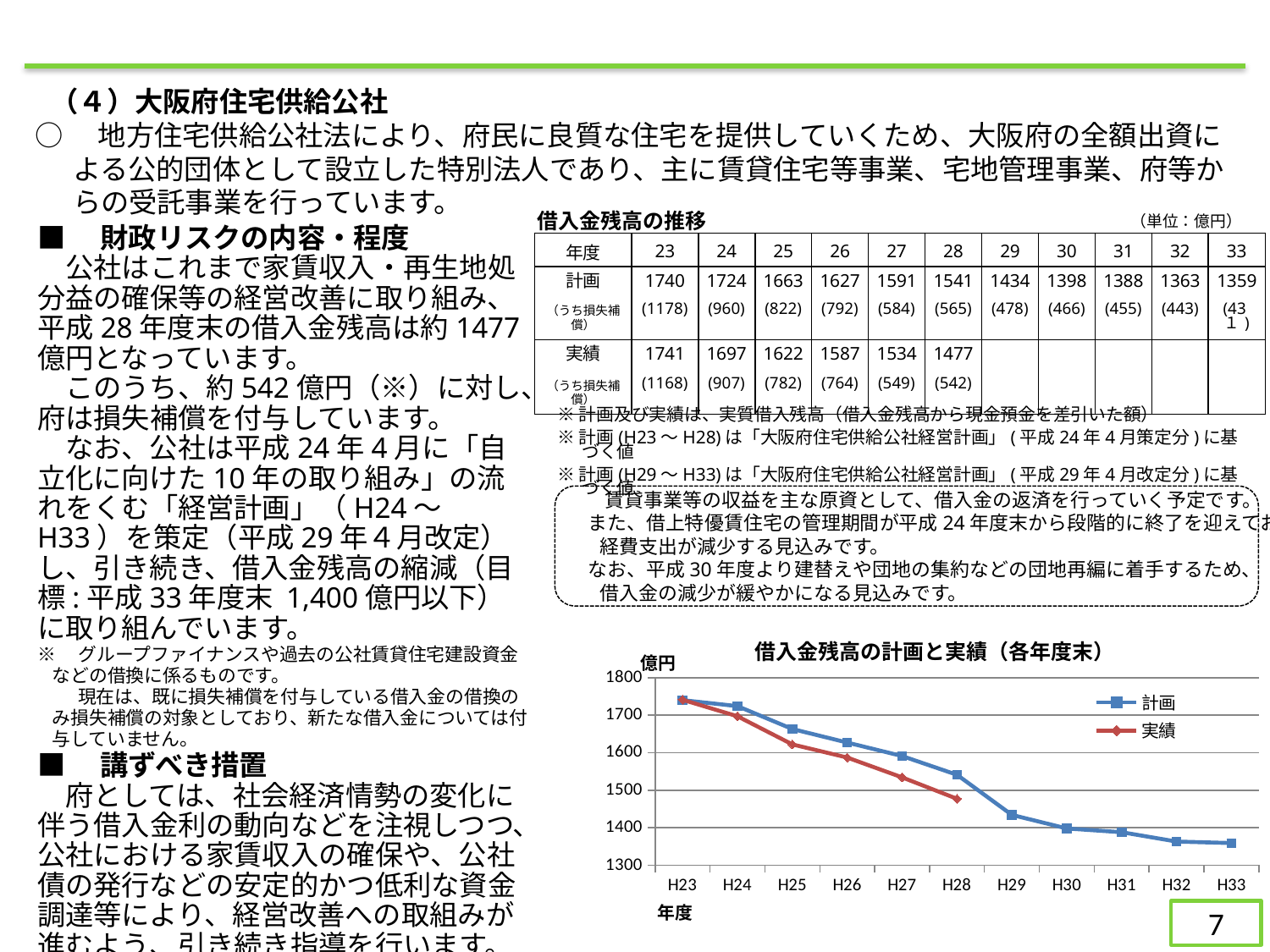
What are the two legend entries in the chart 「借入金残高の計画と実績（各年度末）」? 計画 and 実績 How many series does the legend of the chart 「借入金残高の計画と実績（各年度末）」 list? 2 In the chart 「借入金残高の計画と実績（各年度末）」, at which year is the 実績 series lowest? H28 In the chart 「借入金残高の計画と実績（各年度末）」, how many points are plotted for the 計画 series? 11 According to the table 「借入金残高の推移」, what is the 実績 value for year 28? 1477 In the chart 「借入金残高の計画と実績（各年度末）」, is the 実績 value for H27 greater or less than 1500? greater In the chart 「借入金残高の計画と実績（各年度末）」, how many points are plotted for the 実績 series? 6 In the chart 「借入金残高の計画と実績（各年度末）」, at H28 which series has the higher value, 計画 or 実績? 計画 In the chart 「借入金残高の計画と実績（各年度末）」, is the 計画 value for H33 greater or less than 1400? less In the chart 「借入金残高の計画と実績（各年度末）」, do the 計画 values rise or fall from H23 to H33? fall What kind of chart is 「借入金残高の計画と実績（各年度末）」? line chart In the chart 「借入金残高の計画と実績（各年度末）」, is the 計画 value for H29 greater or less than 1500? less